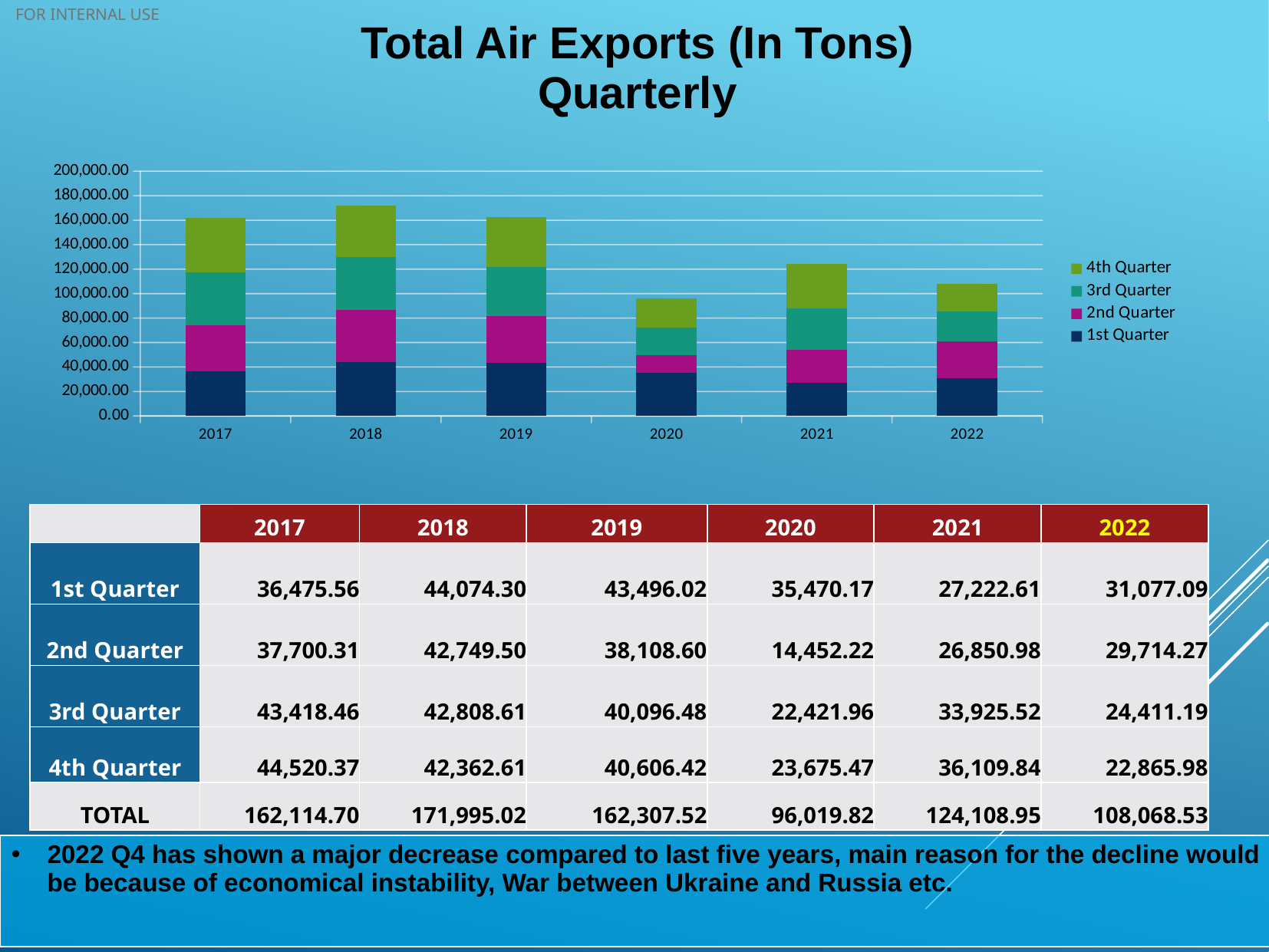
What is the total of the stacked bar for 2020? 96,019.82 How many years are shown along the x axis of the chart? 6 What is the difference between the total for 2018 and the total for 2017? 9,880.32 Which year has the highest total air exports? 2018 What kind of chart is shown on the slide? Stacked bar chart Is the total for 2020 greater or less than 100,000.00? less Which year has the lowest total air exports? 2020 What is the 4th Quarter value for 2022? 22,865.98 What is the 1st Quarter value for 2017? 36,475.56 Which year has the larger total, 2021 or 2022? 2021 Does the total air exports rise or fall from 2019 to 2020? fall How many series does the chart legend list? 4